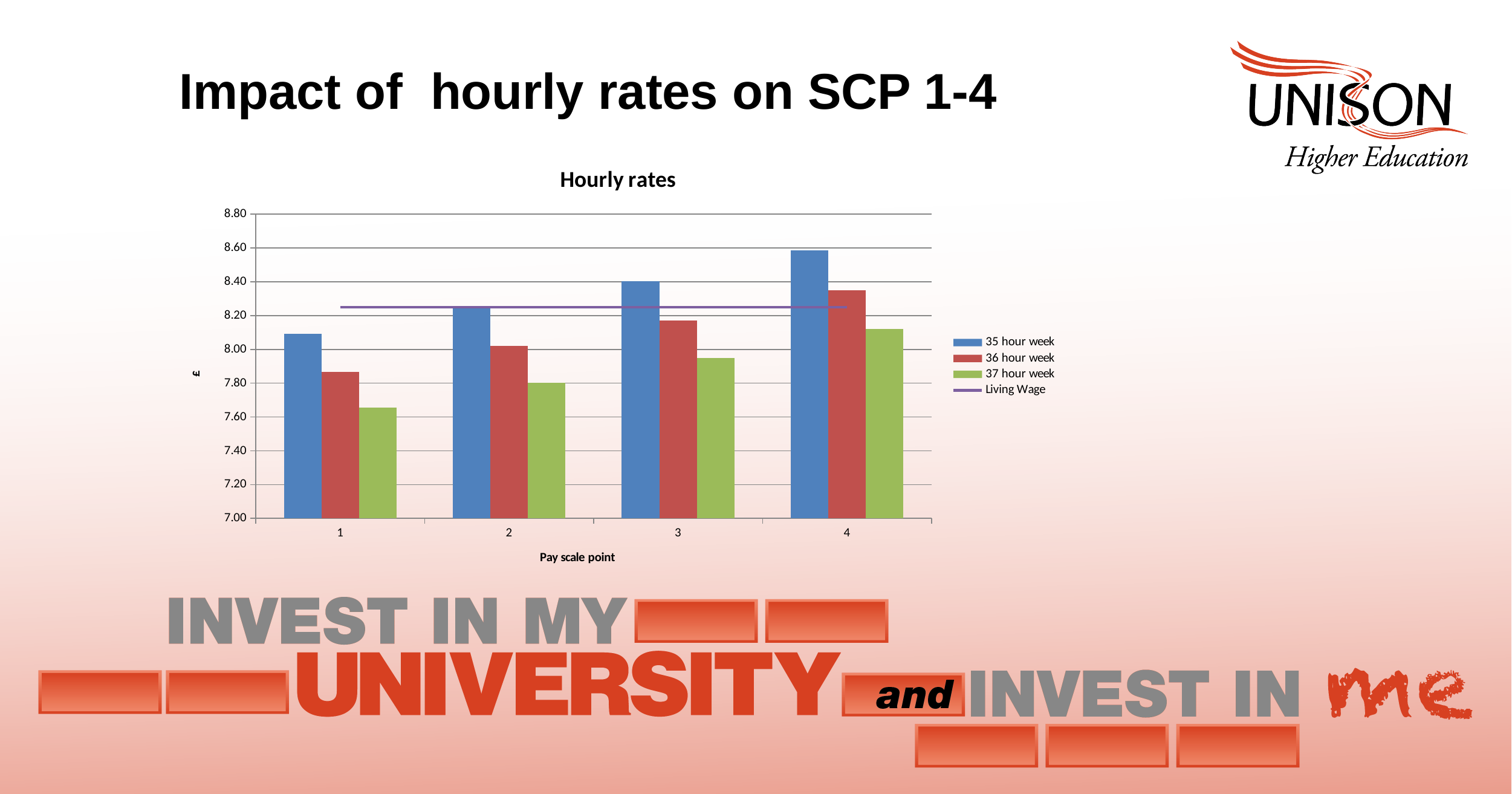
Is the 36 hour week value at pay scale point 4 greater or less than 8.20? greater Do the 36 hour week values rise or fall as the pay scale point increases from 1 to 4? rise Is the 37 hour week value at pay scale point 1 greater or less than 7.80? less What type of chart is shown on the slide? combination bar and line chart At pay scale point 3, which is larger: the 35 hour week bar or the 37 hour week bar? 35 hour week How many pay scale points are shown on the x axis of the Hourly rates chart? 4 What is the label on the x axis of the Hourly rates chart? Pay scale point Is the 35 hour week value at pay scale point 1 greater or less than 8.00? greater Which pay scale point has the highest 35 hour week bar? 4 Which series has the lowest bar at pay scale point 1? 37 hour week How many entries does the legend of the Hourly rates chart list? 4